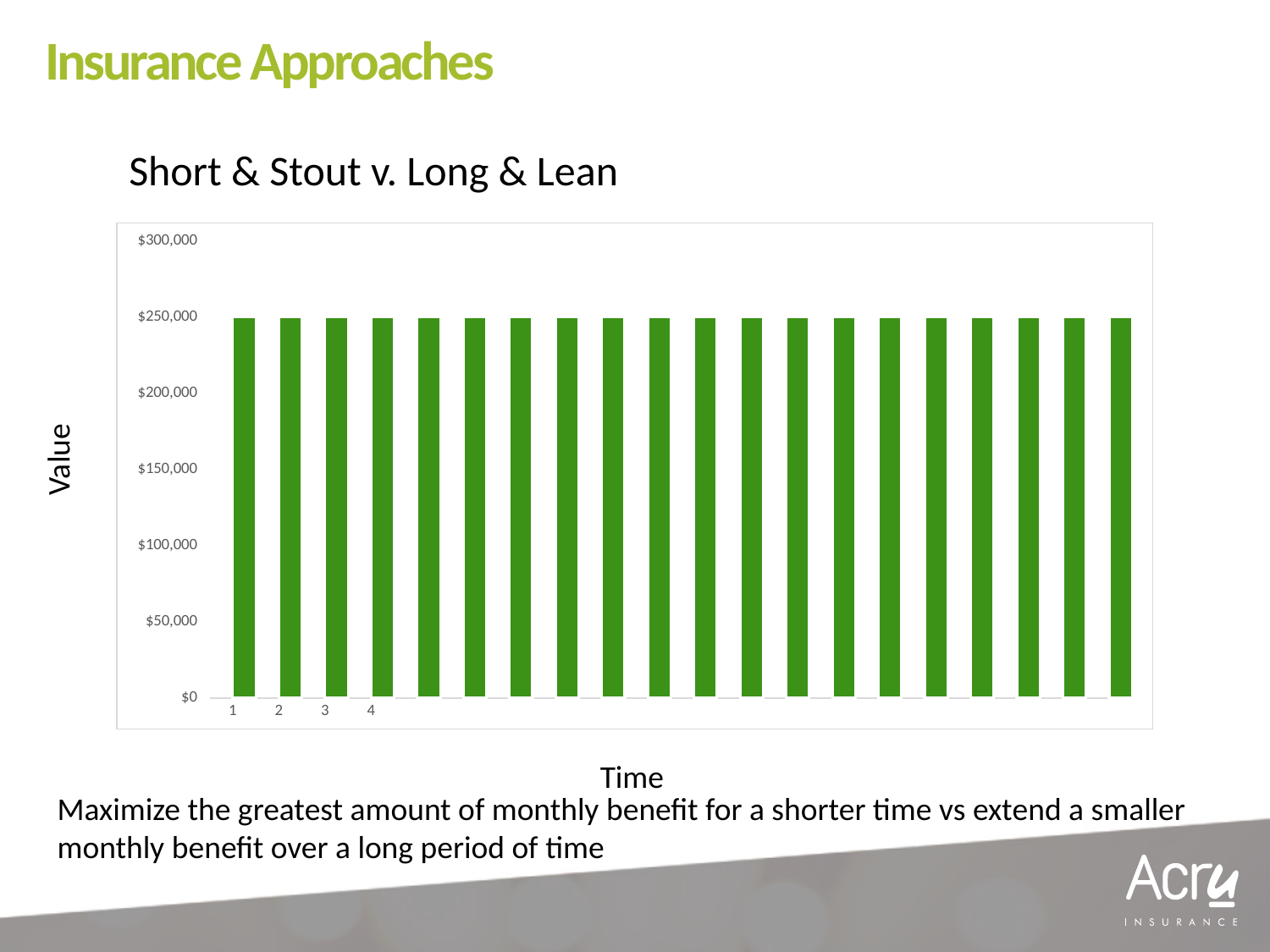
What is the highest value shown on the vertical axis? $300,000 Is the value for category 1 greater or less than $200,000? greater Is the value for category 2 greater or less than $150,000? greater What kind of chart is shown on the slide? bar chart What is the label of the vertical axis? Value Do the bar values rise, fall, or stay flat along the x axis? stay flat How many bars are plotted in the chart? 20 What is the title of the chart? Short & Stout v. Long & Lean Is the value for category 4 greater or less than $100,000? greater